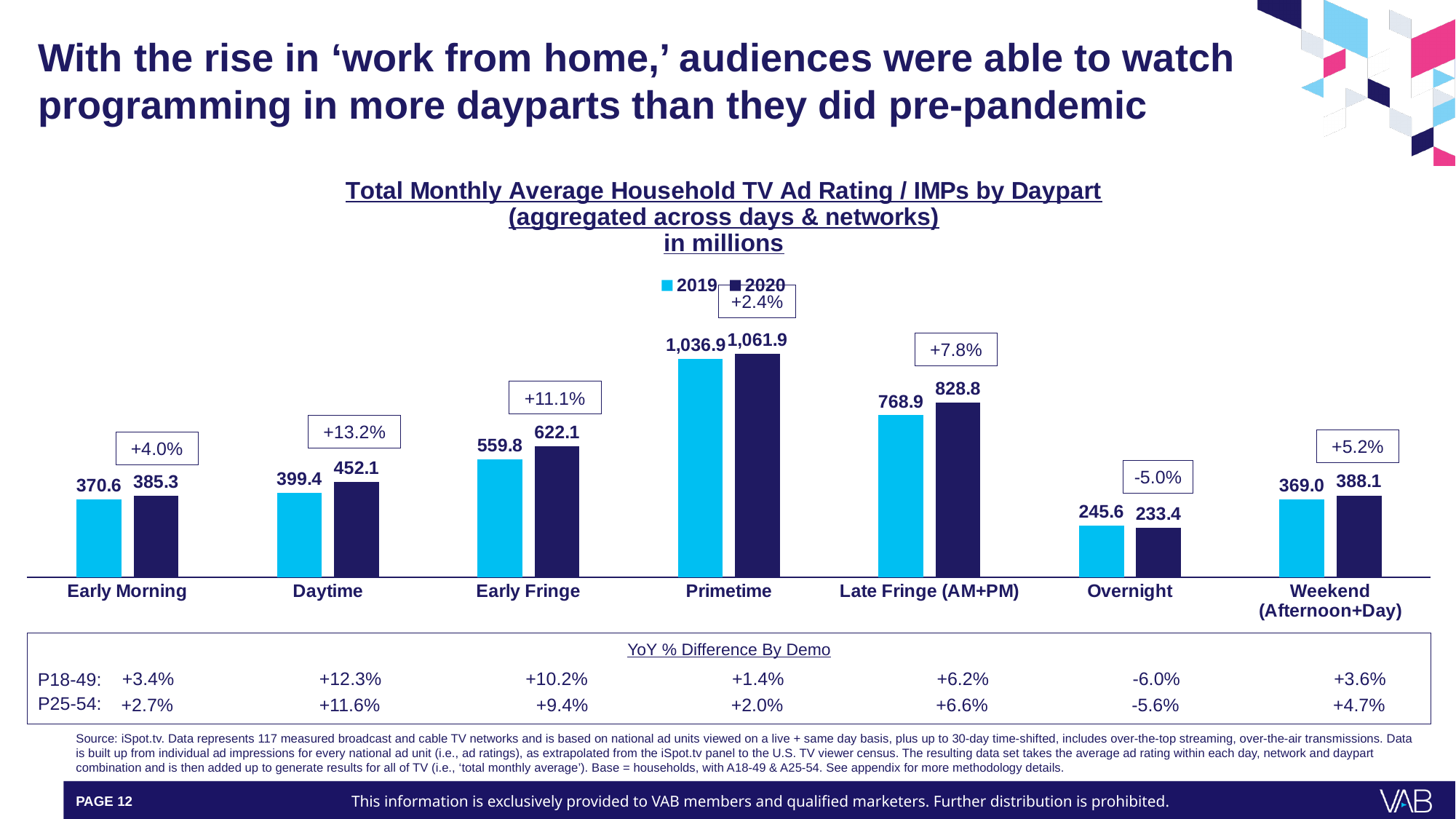
What kind of chart is shown on the slide? Bar chart Which daypart has the lowest 2020 value? Overnight What is the 2020 value for Daytime? 452.1 How many series does the legend list? 2 Which daypart has the highest 2019 value? Primetime Which series is shown in light blue in the legend? 2019 Which is larger for Overnight, the 2019 value or the 2020 value? 2019 What is the 2019 value for Overnight? 245.6 What is the difference between the 2020 and 2019 values for Early Fringe? 62.3 What percentage change is shown above the Late Fringe (AM+PM) bars? +7.8% What is the 2020 value for Primetime? 1,061.9 How many dayparts are shown on the x axis? 7